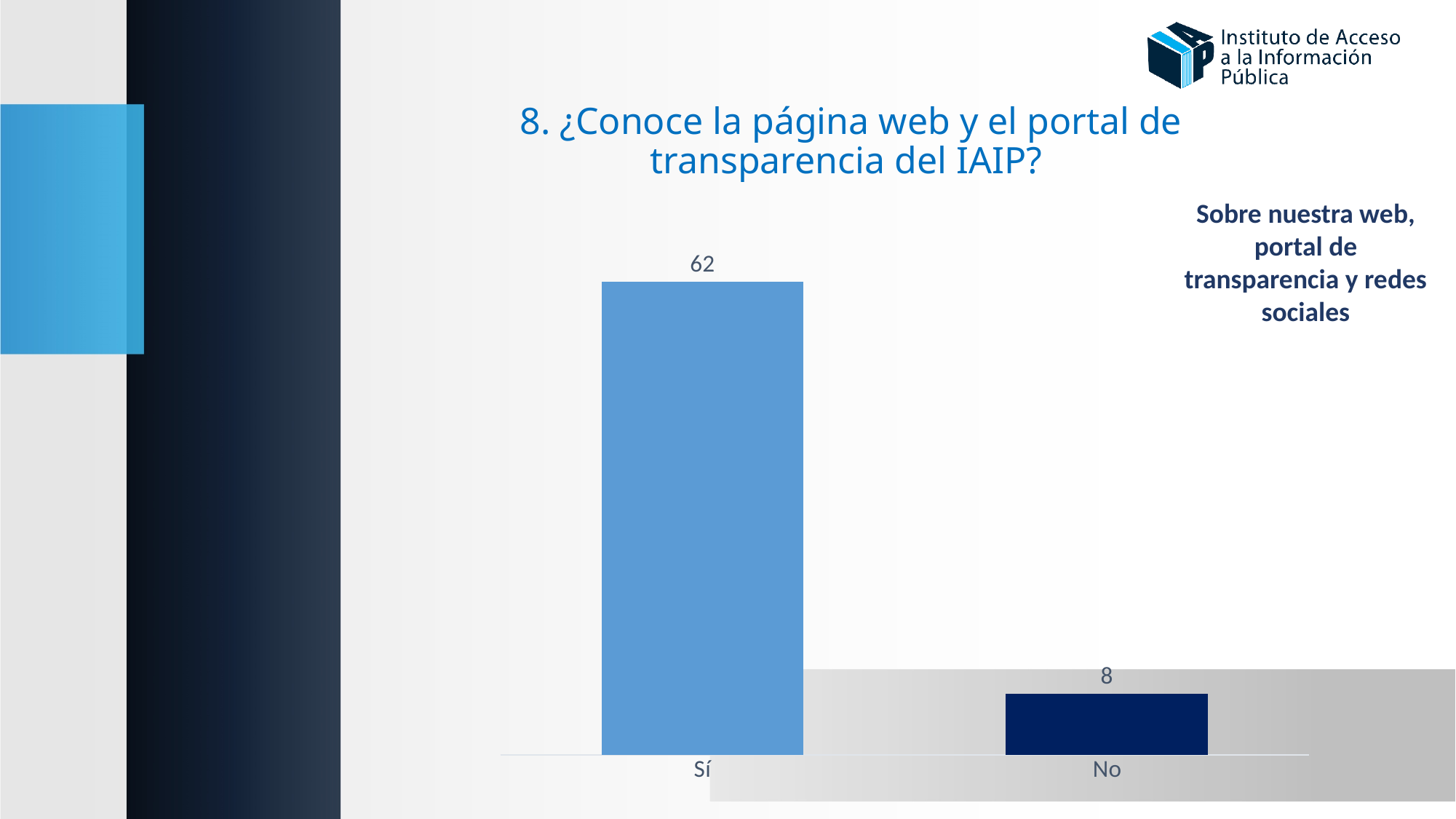
Which category has the highest value? Sí What is the total of the values for "Sí" and "No"? 70 What is the value for "No"? 8 What is the difference between the values for "Sí" and "No"? 54 Which category has the lowest value? No What kind of chart is shown on the slide? Bar chart Which is larger, the value for "Sí" or the value for "No"? Sí What colour is the bar for "No"? Dark navy blue How many categories are shown in the chart? 2 What is the value for "Sí"? 62 What is the title of the chart? 8. ¿Conoce la página web y el portal de transparencia del IAIP?